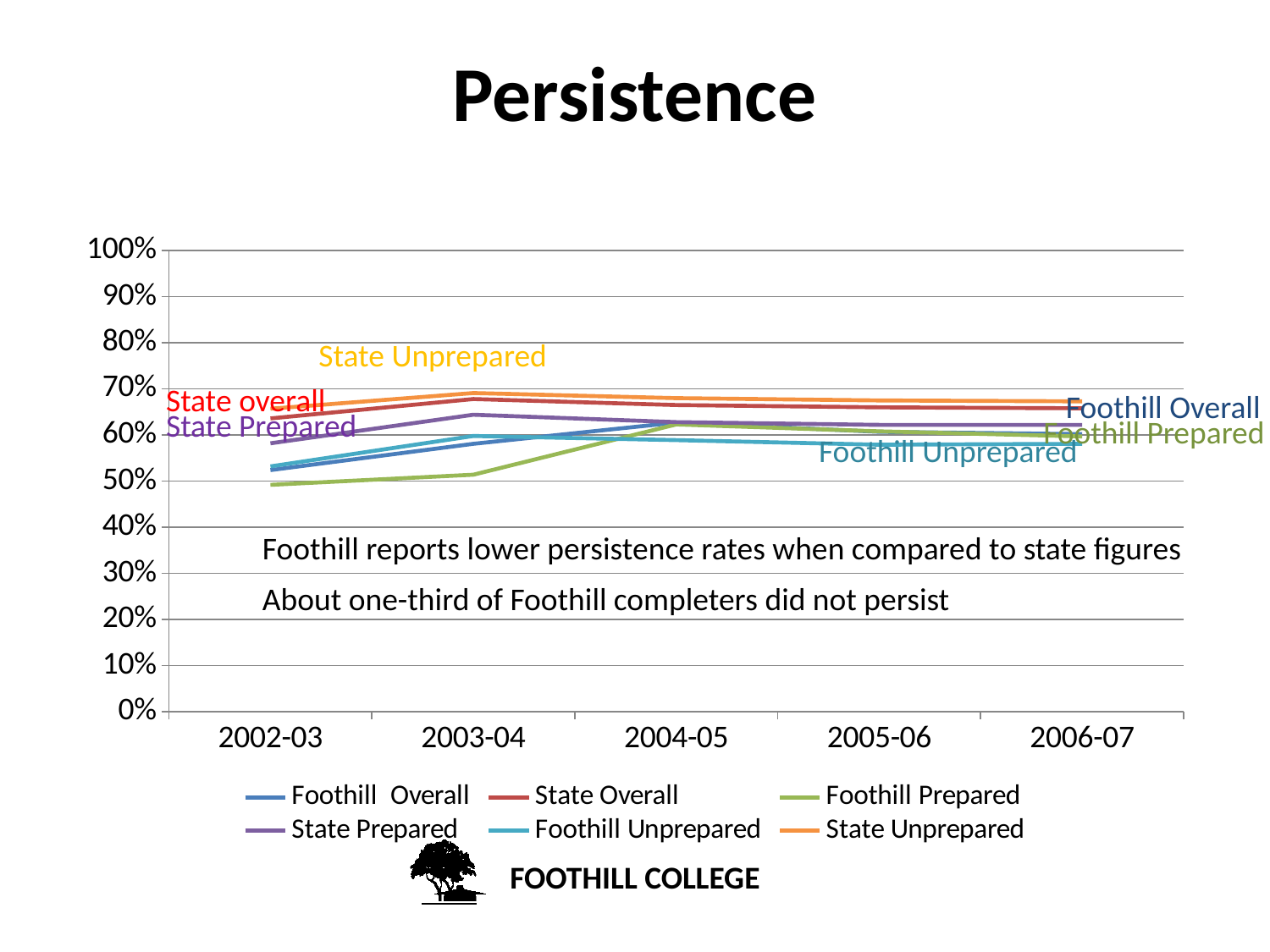
Is the value for State Unprepared in 2003-04 greater or less than 60%? greater Is the value for Foothill Prepared in 2002-03 greater or less than 60%? less What kind of chart is shown on the slide? line chart Is the value for Foothill Unprepared in 2006-07 greater or less than 70%? less Does the Foothill Prepared line rise or fall from 2002-03 to 2004-05? rise Which series has the highest value in 2002-03? State Unprepared How many series does the legend list? 6 How many academic years are plotted along the x axis? 5 In 2002-03, which is larger: State Overall or Foothill Overall? State Overall Which series has the lowest value in 2002-03? Foothill Prepared What is the title of the chart? Persistence Which series is listed first in the legend? Foothill Overall